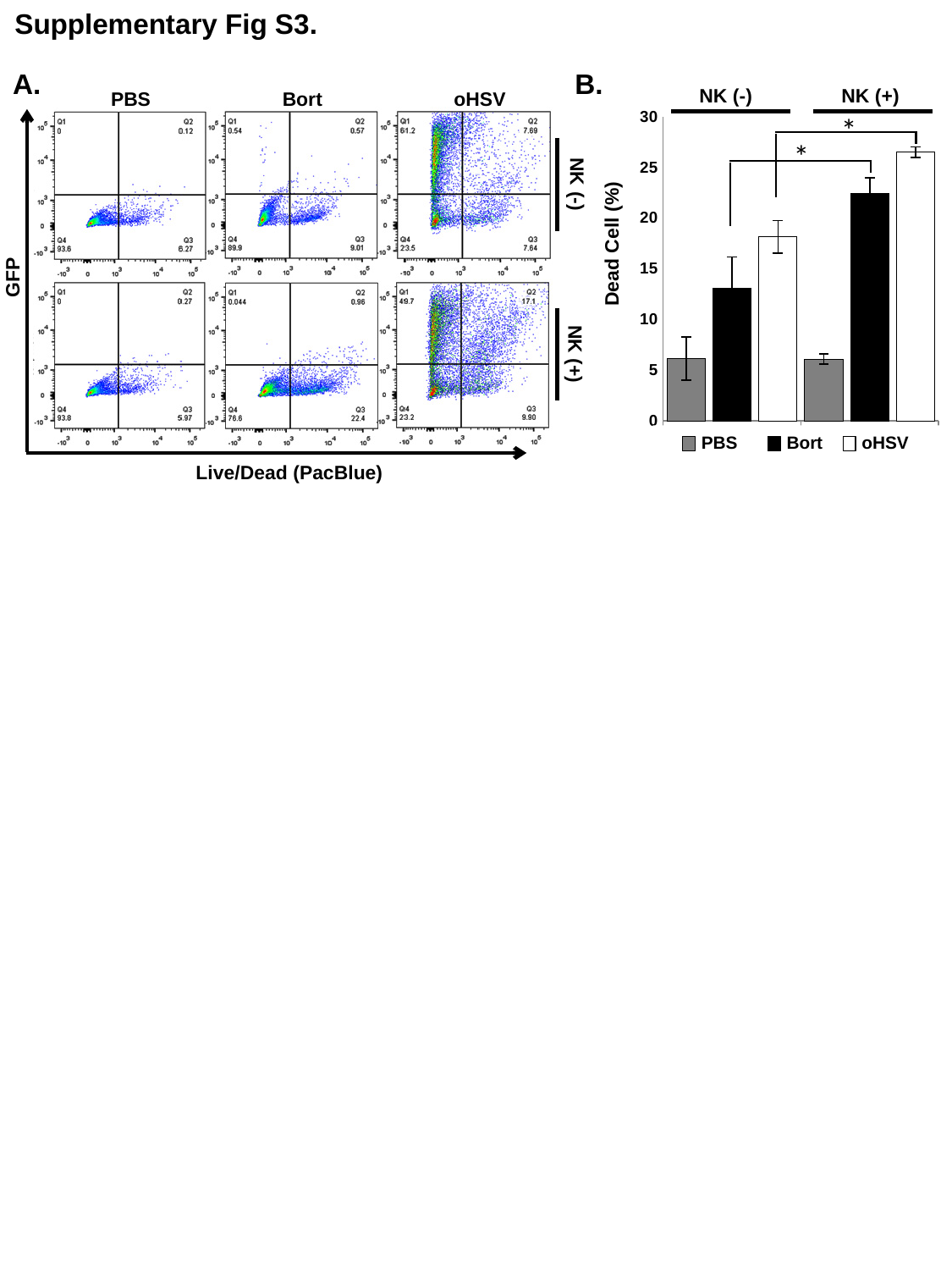
In the bar chart in panel B, is the Bort value in the NK (+) group greater or less than 20? greater In the bar chart in panel B, which bar is the highest? oHSV in NK (+) In panel A, what is the Q4 value printed in the PBS NK (-) plot? 93.6 In the bar chart in panel B, which series has the lowest bar in the NK (+) group? PBS In the bar chart in panel B, what is the y-axis title? Dead Cell (%) In panel A, what is the Q2 value printed in the oHSV NK (+) plot? 17.1 In the bar chart in panel B, how many bars are plotted in total? 6 In the bar chart in panel B, is the oHSV value in the NK (-) group greater or less than 20? less In the bar chart in panel B, which is larger: the Bort bar in NK (-) or the Bort bar in NK (+)? Bort in NK (+) In the bar chart in panel B, what kind of chart is it? bar chart In the bar chart in panel B, how many series does the legend list? 3 In the bar chart in panel B, is the Bort value in the NK (-) group greater or less than 10? greater